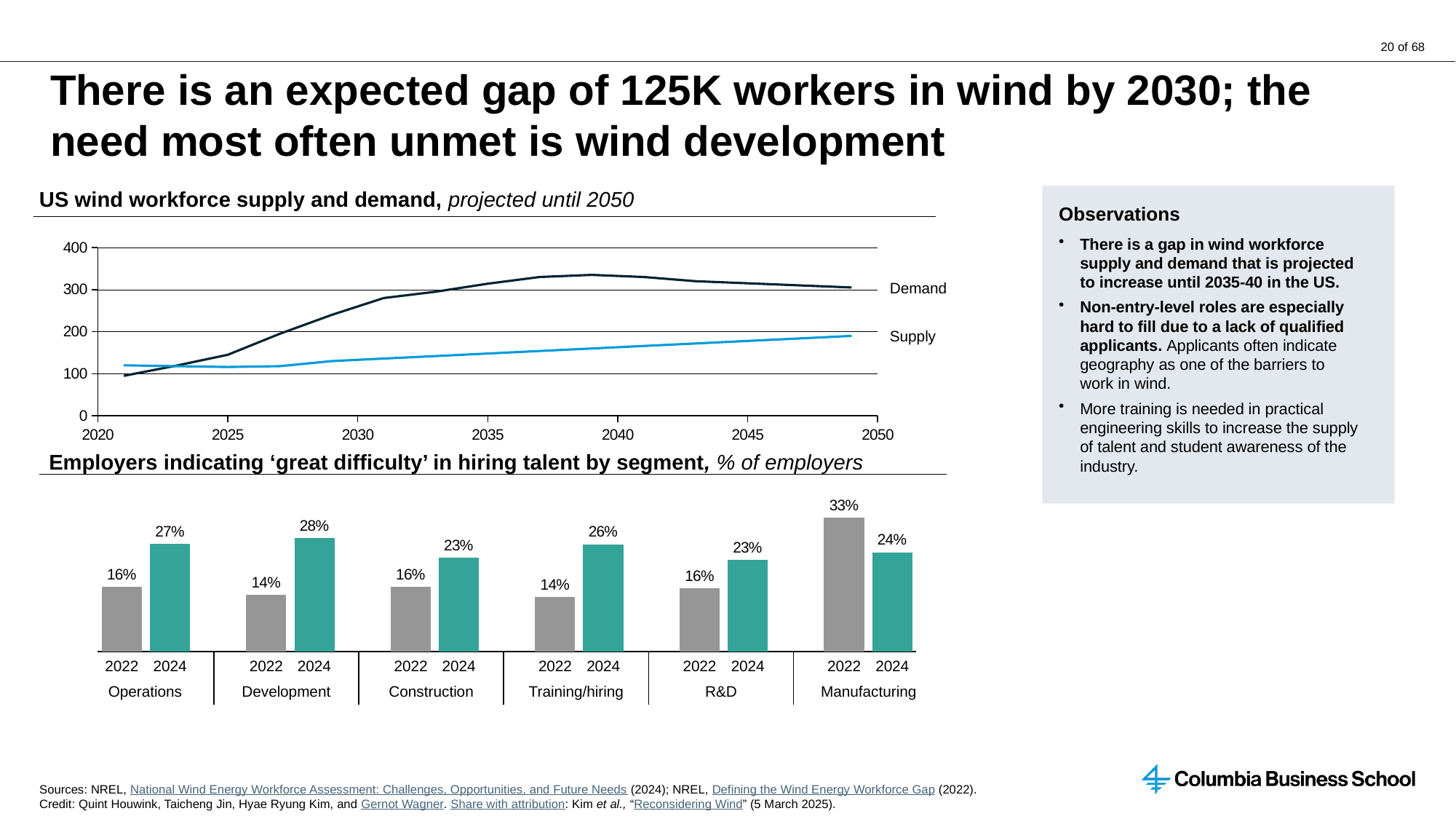
In the 'Employers indicating great difficulty in hiring talent by segment' chart, is the 2022 value for Manufacturing larger or smaller than its 2024 value? larger How many segments are shown in the 'Employers indicating great difficulty in hiring talent by segment' chart? 6 In the 'Employers indicating great difficulty in hiring talent by segment' chart, what is the 2022 value for Manufacturing? 33% In the 'Employers indicating great difficulty in hiring talent by segment' chart, which segment has the highest 2022 value? Manufacturing In the 'Employers indicating great difficulty in hiring talent by segment' chart, what is the difference between the 2024 and 2022 values for Development? 14 percentage points In the 'Employers indicating great difficulty in hiring talent by segment' chart, what is the 2024 value for Training/hiring? 26% In the 'US wind workforce supply and demand' chart, is the Demand value in 2040 greater or less than 300? greater What type of chart is the 'Employers indicating great difficulty in hiring talent by segment' chart? bar chart In the 'Employers indicating great difficulty in hiring talent by segment' chart, which segment has the highest 2024 value? Development What type of chart is the 'US wind workforce supply and demand' chart? line chart In the 'US wind workforce supply and demand' chart, does the Supply line rise or fall from 2030 to 2050? rise In the 'Employers indicating great difficulty in hiring talent by segment' chart, what is the 2024 value for Development? 28%